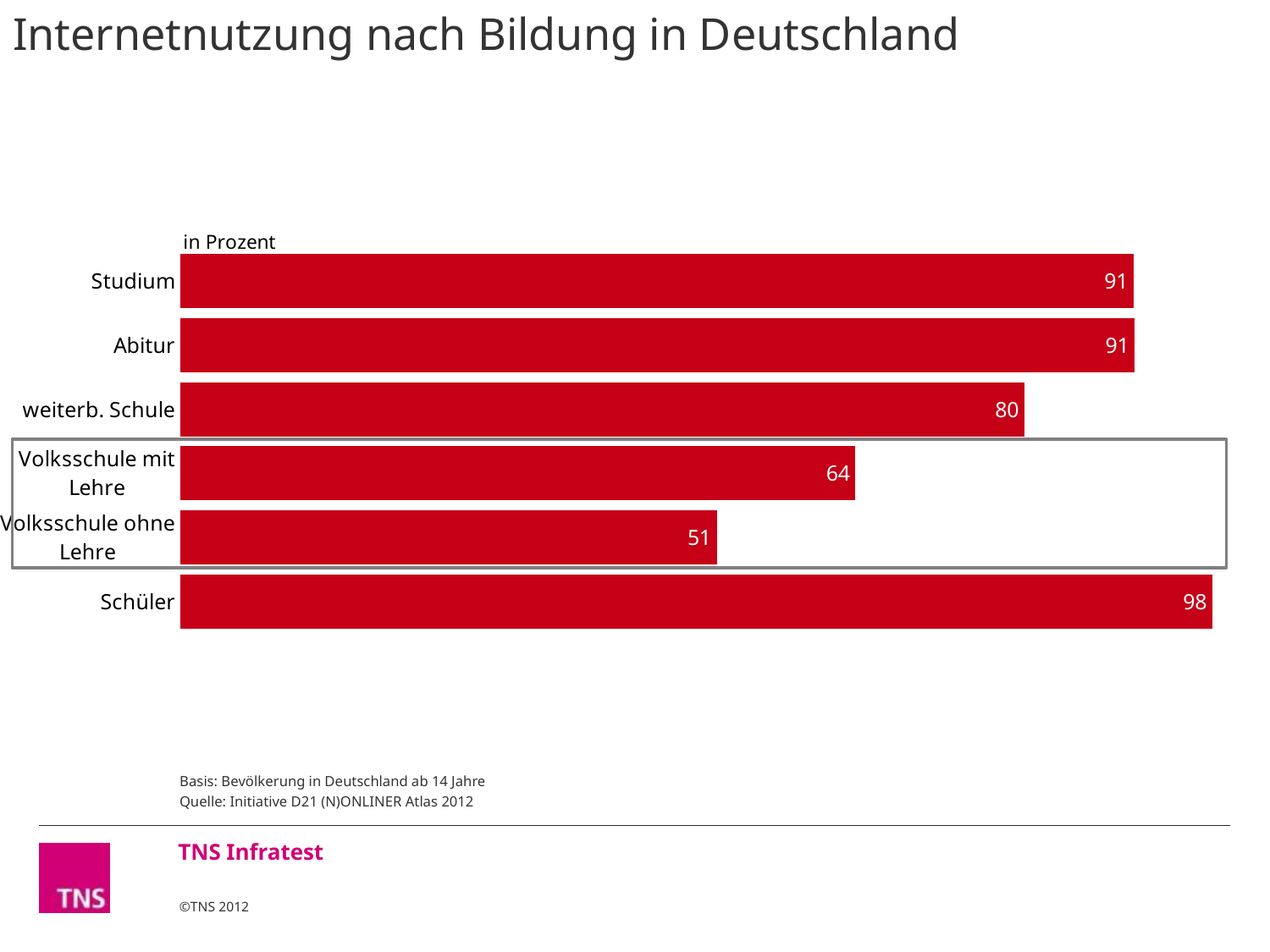
Which category has the highest value? Schüler How many categories are shown in the chart? 6 What is the title of the slide? Internetnutzung nach Bildung in Deutschland Which is larger, the value for Abitur or the value for weiterb. Schule? Abitur What is the difference between the values for Schüler and weiterb. Schule? 18 Which category has the lowest value? Volksschule ohne Lehre What is the value for weiterb. Schule? 80 What kind of chart is shown on the slide? Bar chart What is the value for Schüler? 98 What is the difference between the values for Volksschule mit Lehre and Volksschule ohne Lehre? 13 What is the value for Studium? 91 What is the value for Volksschule ohne Lehre? 51